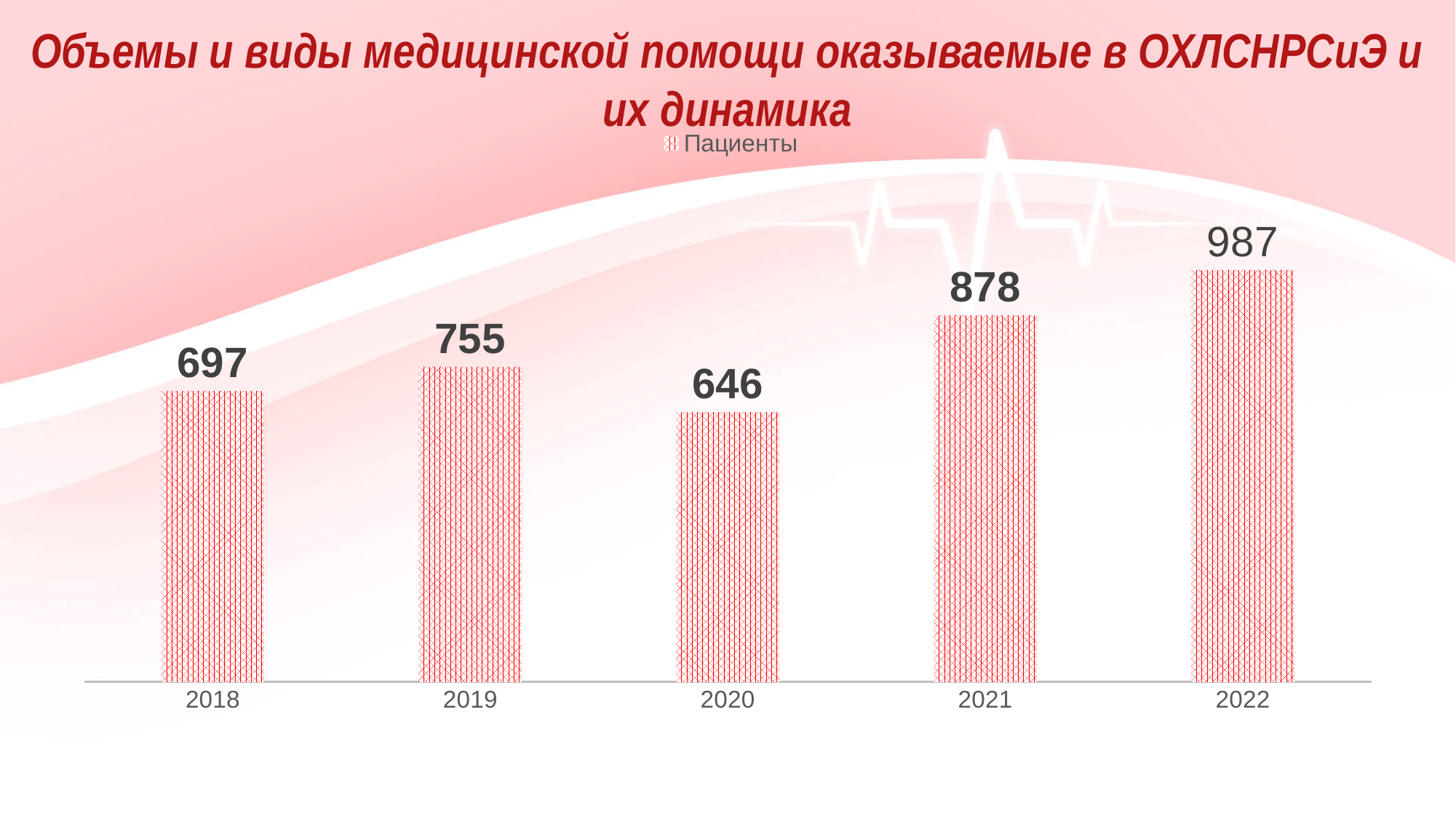
What is the difference between the values for 2022 and 2021? 109 Which is larger, the value for 2019 or the value for 2018? 2019 Which year has the lowest value? 2020 What is the value for 2020? 646 Which year has the highest value? 2022 What is the name of the series shown in the legend? Пациенты How many years are shown on the x axis? 5 What is the difference between the values for 2019 and 2020? 109 What is the value for 2018? 697 How many series does the legend list? 1 What kind of chart is shown on the slide? bar chart What is the value for 2022? 987